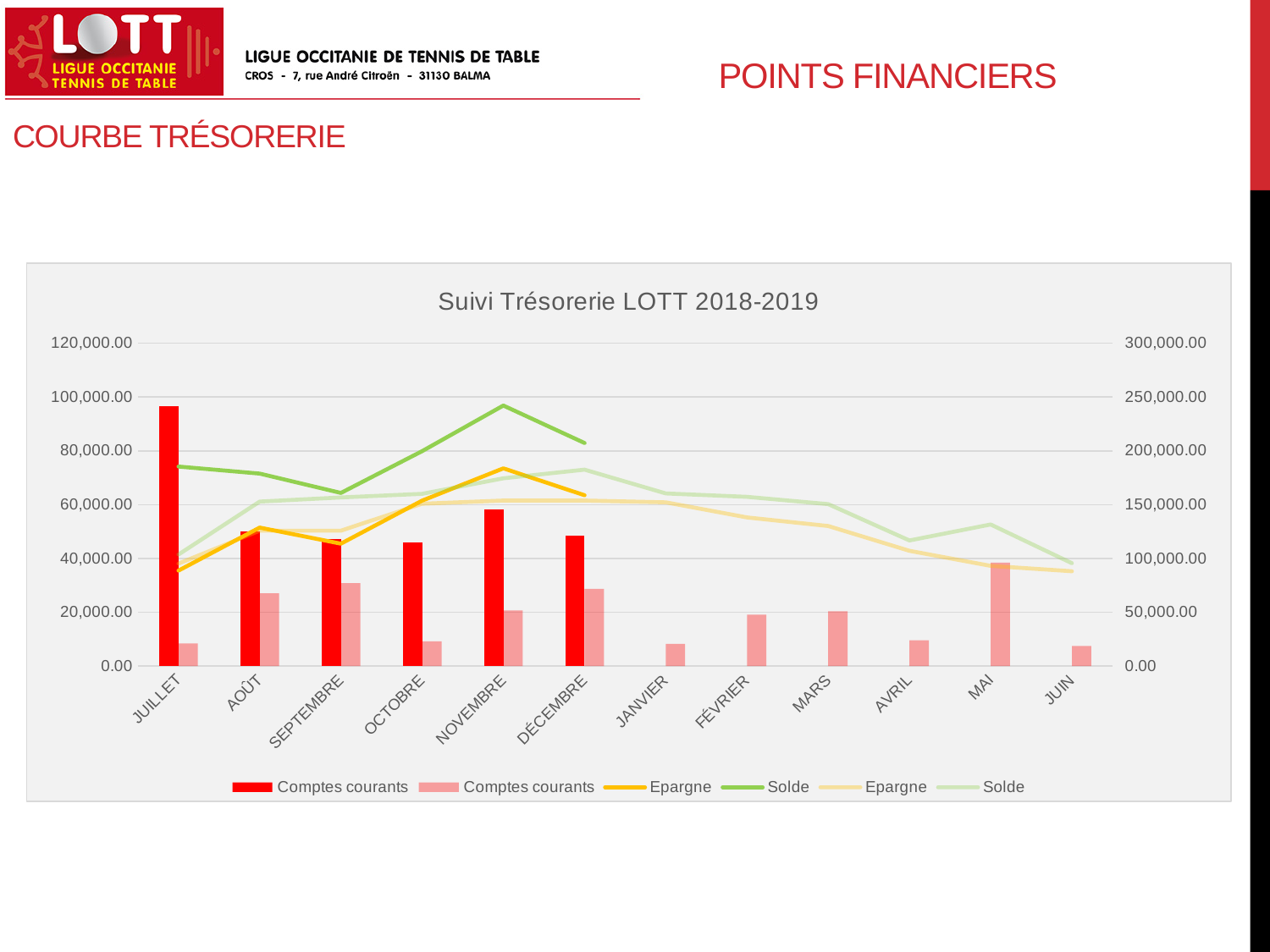
Do the bright red Comptes courants bars rise or fall from JUILLET to SEPTEMBRE? fall What kind of chart is shown on the slide? A combined bar and line chart Reading the left axis, is the bright red Comptes courants bar for JUILLET greater or less than 80,000.00? greater How many series does the chart legend list? 6 Reading the left axis, is the light pink Comptes courants bar for MAI greater or less than 20,000.00? greater Which is larger, the light pink Comptes courants bar for MAI or for FÉVRIER? MAI Which is larger, the bright red Comptes courants bar for JUILLET or for DÉCEMBRE? JUILLET How many months are shown on the x axis of the chart? 12 In which month is the light pink Comptes courants bar the highest? MAI In which month does the dark green Solde line reach its peak? NOVEMBRE What is the title of the chart? Suivi Trésorerie LOTT 2018-2019 In which month is the bright red Comptes courants bar the highest? JUILLET